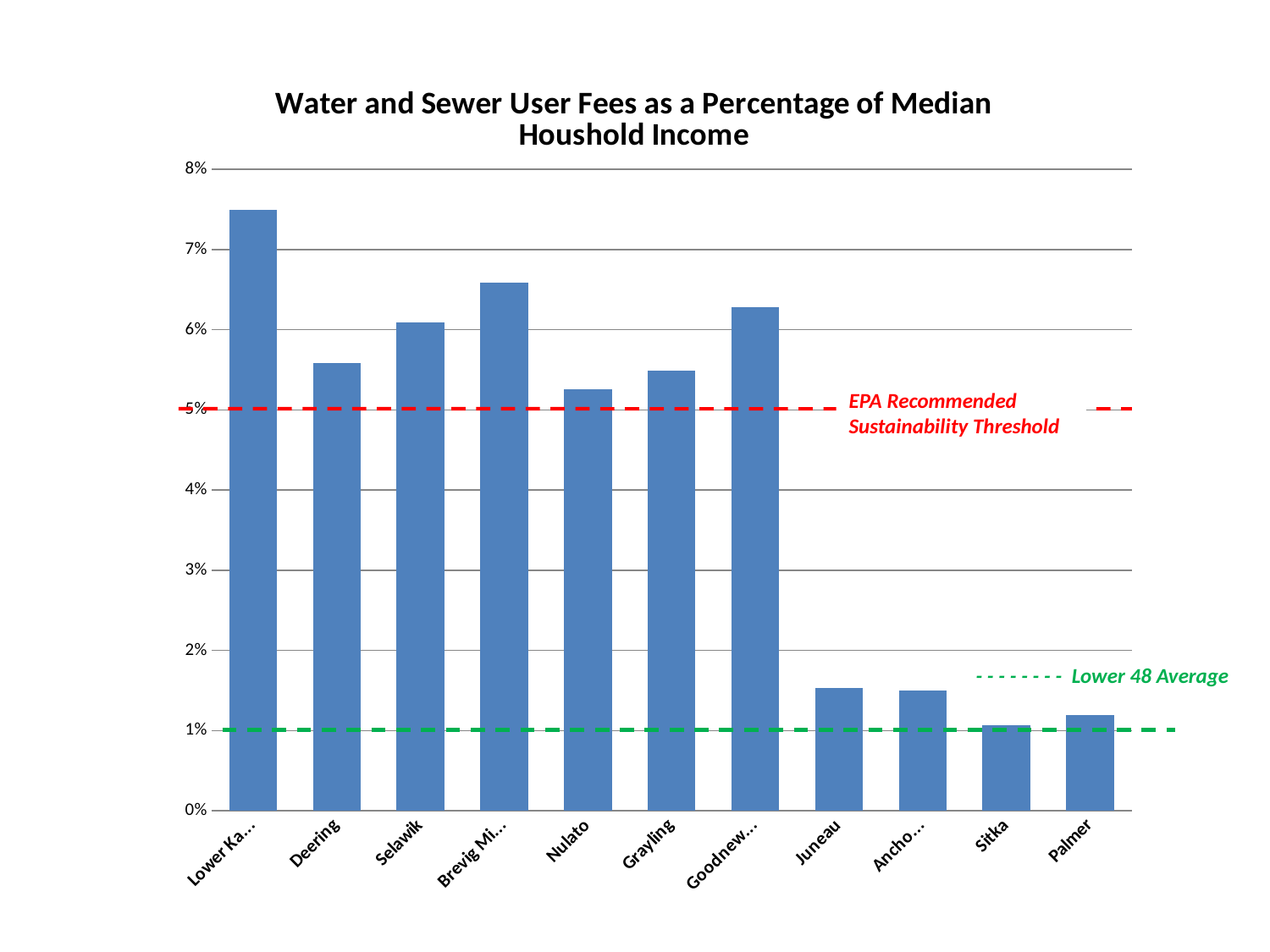
Which has the larger value, Juneau or Palmer? Juneau Is the value for Palmer greater or less than 2%? less Is the value for Selawik greater or less than 5%? greater Is the value for Deering greater or less than 5%? greater How many communities (categories) are plotted on the x axis? 11 What does the red dashed line on the chart represent? EPA Recommended Sustainability Threshold Which community has the lowest water and sewer user fees as a percentage of median household income? Sitka What kind of chart is shown on the slide? bar chart Which has the larger value, Deering or Selawik? Selawik What does the green dashed line on the chart represent? Lower 48 Average